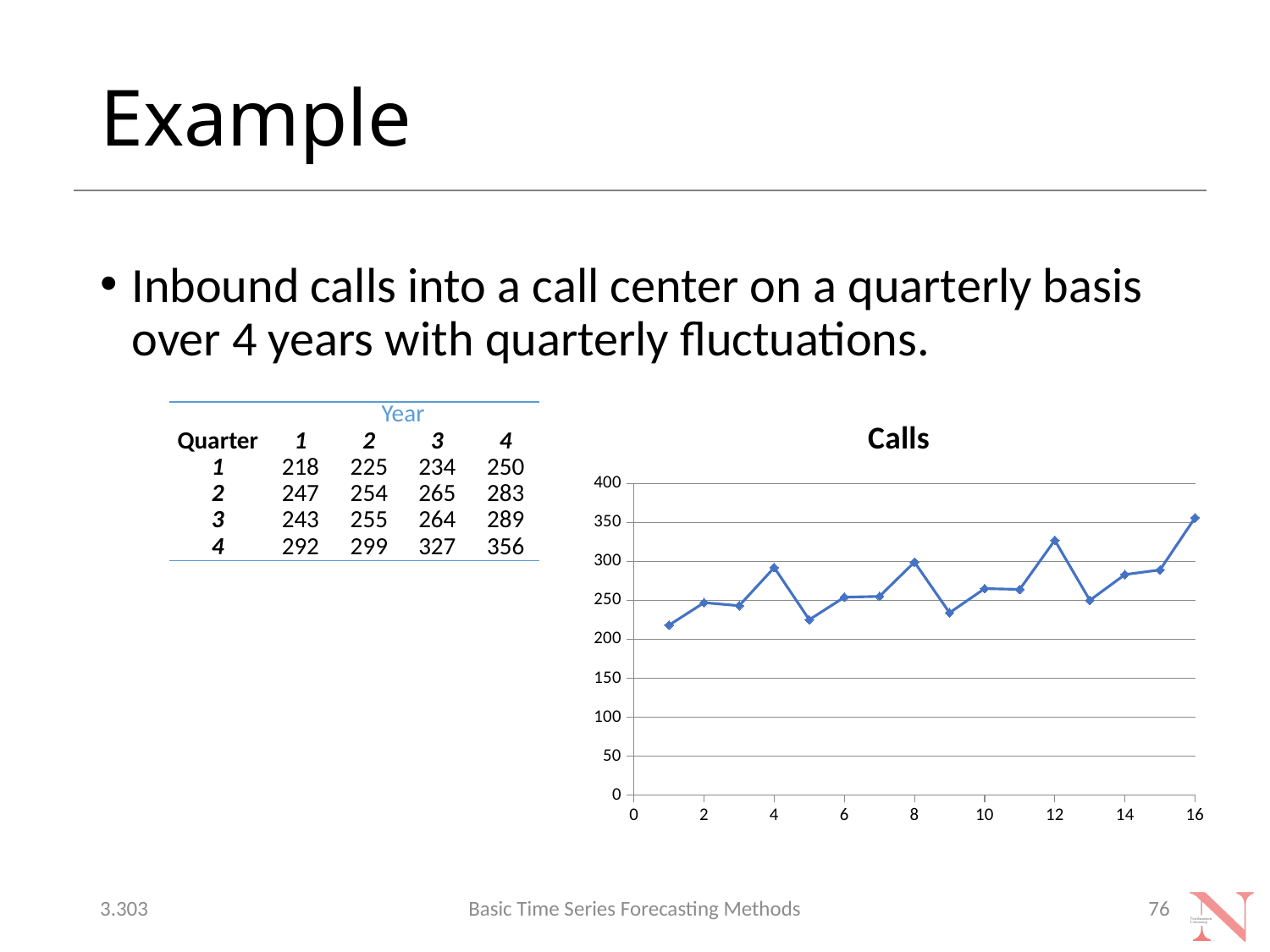
How many data points are plotted on the Calls chart? 16 What is the title of the chart? Calls Which is larger on the Calls chart, the value at x = 8 or the value at x = 9? x = 8 At which x-axis position does the Calls chart have its lowest value? 1 Which is larger on the Calls chart, the value at x = 4 or the value at x = 5? x = 4 According to the table on the slide, what is the number of calls in Quarter 4 of Year 4 (the last point on the chart)? 356 Is the value at x = 12 on the Calls chart greater or less than 300? greater Is the value at x = 1 on the Calls chart greater or less than 250? less Do the values on the Calls chart generally rise or fall from left to right? rise Is the value at x = 16 on the Calls chart greater or less than 300? greater At which x-axis position does the Calls chart reach its highest value? 16 What kind of chart is shown on the slide? line chart